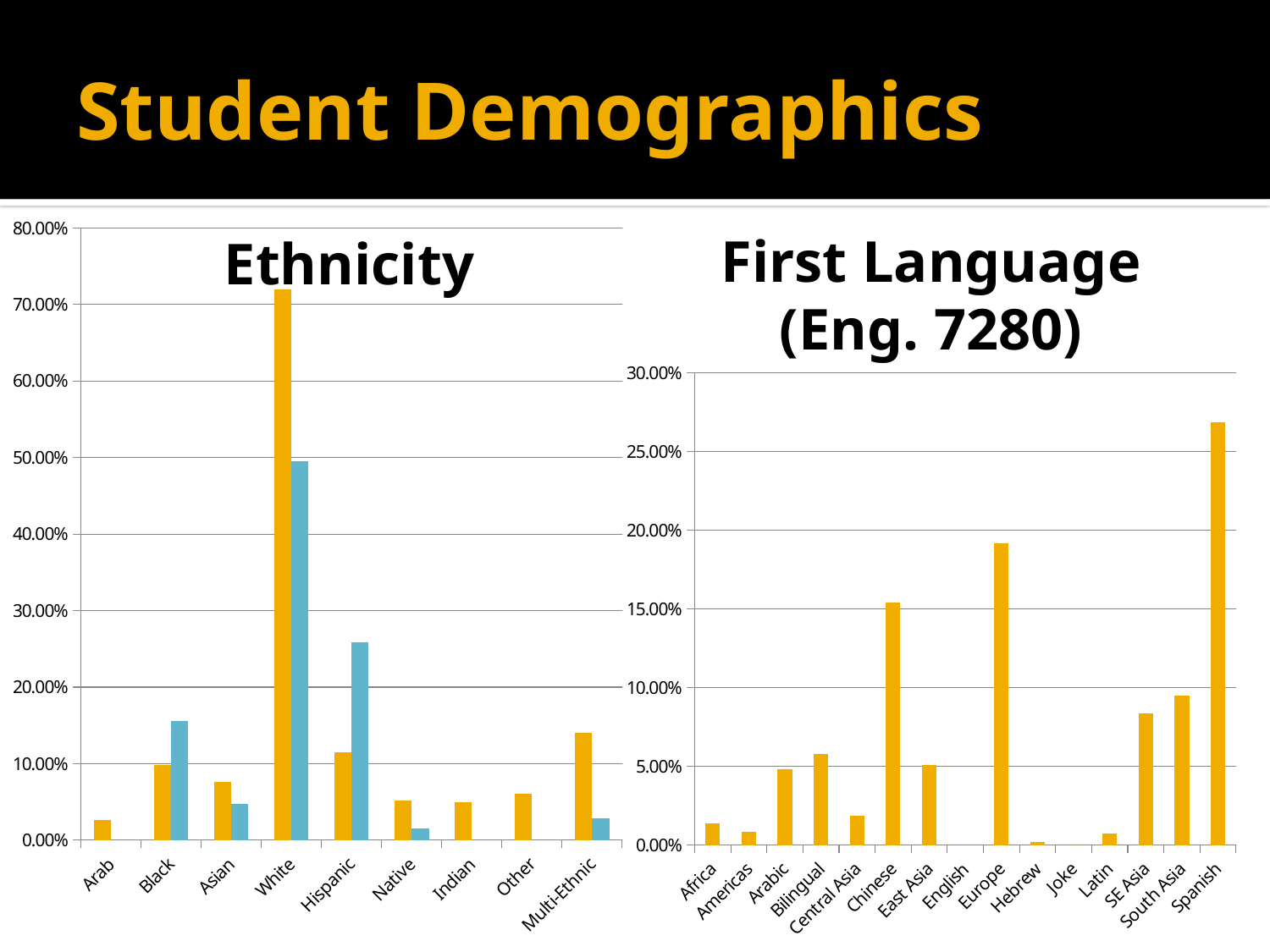
In the Ethnicity chart, is the blue bar for Hispanic greater or less than 20.00%? greater In the First Language (Eng. 7280) chart, which is larger, the value for Europe or the value for Chinese? Europe In the First Language (Eng. 7280) chart, which language has the highest value? Spanish In the First Language (Eng. 7280) chart, is the value for Europe greater or less than 20.00%? less What kind of chart is the Ethnicity chart? bar chart In the Ethnicity chart, which category has the tallest orange bar? White How many ethnicity categories are shown on the x axis of the Ethnicity chart? 9 In the Ethnicity chart, for Black, which bar is taller, the orange one or the blue one? the blue one In the Ethnicity chart, is the orange bar for White greater or less than 70.00%? greater How many language categories are listed on the x axis of the First Language (Eng. 7280) chart? 15 In the First Language (Eng. 7280) chart, which is larger, the value for South Asia or the value for SE Asia? South Asia